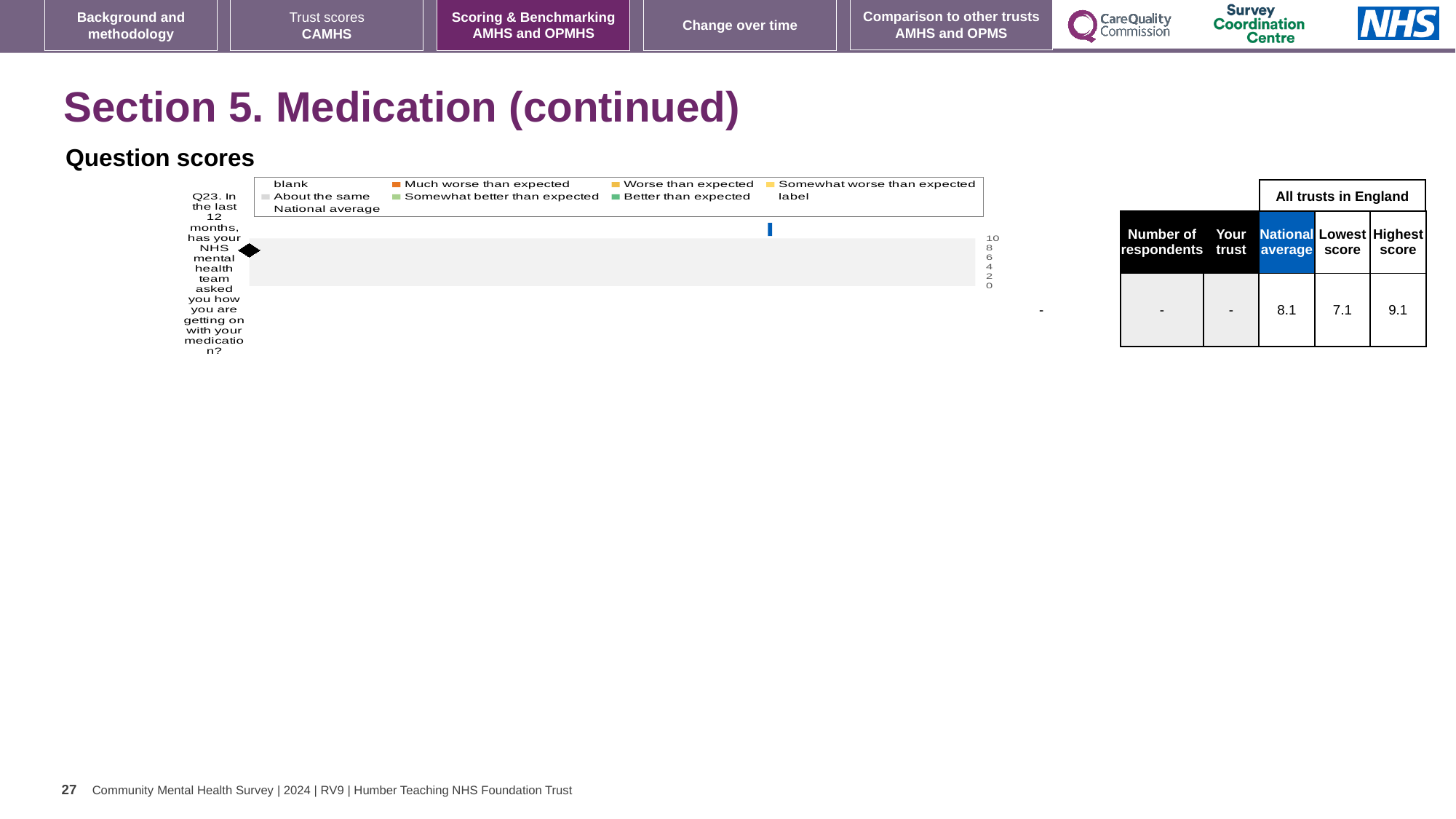
In the table next to the chart, what is the highest score among all trusts in England for Q23? 9.1 How many question categories are plotted on the chart? 1 What is the maximum value shown on the chart's axis? 10 In the table next to the chart, what is the national average score for Q23? 8.1 In the table next to the chart, what is the lowest score among all trusts in England for Q23? 7.1 What kind of chart is shown under 'Question scores'? bar chart In the table next to the chart, which is larger for Q23: the national average or the lowest score? national average Which question is plotted on the chart? Q23 In the table next to the chart, what is the difference between the highest score and the lowest score for Q23? 2.0 In the table next to the chart, what is shown as the number of respondents for Q23? -